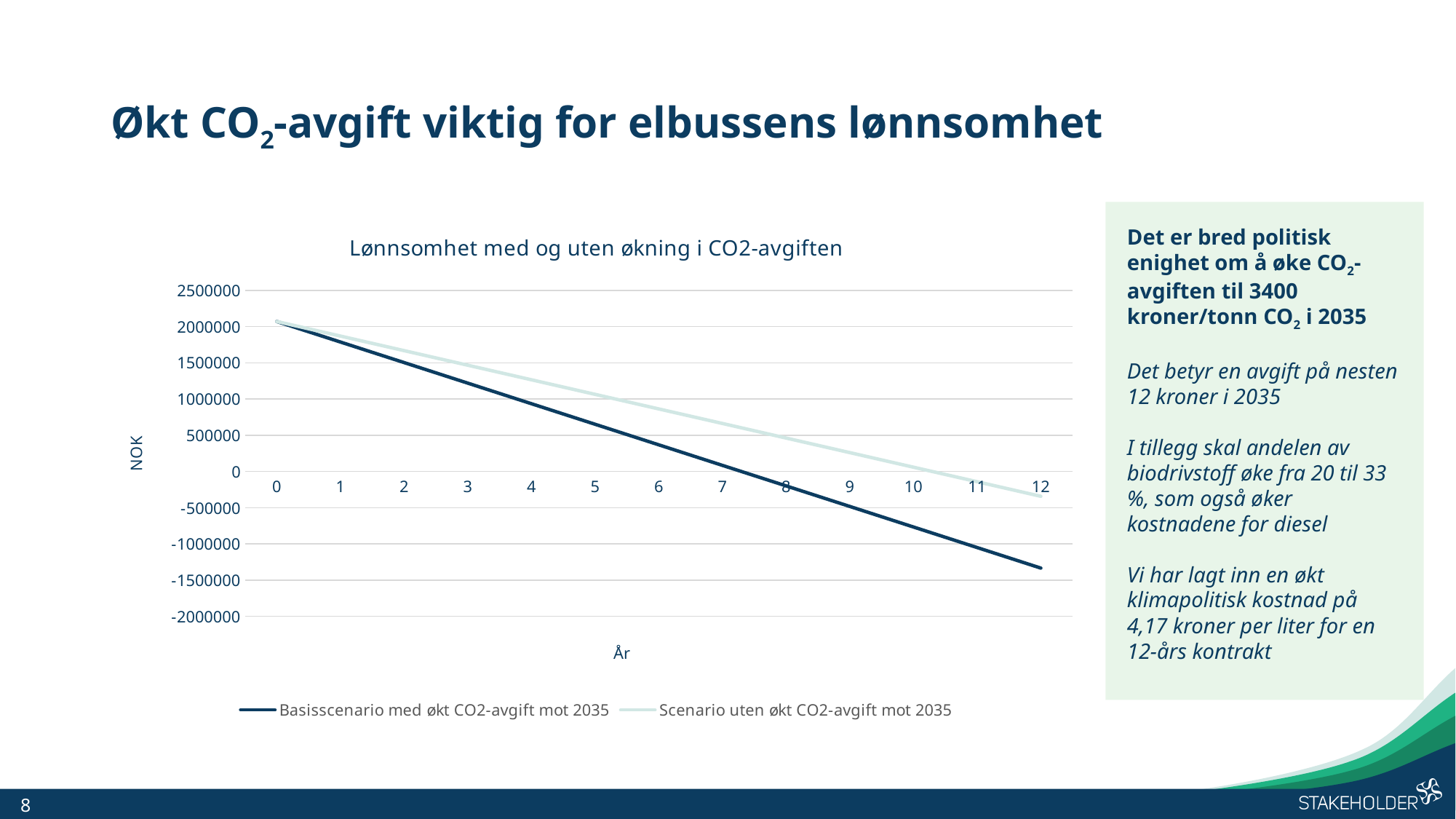
Is the value for 'Basisscenario med økt CO2-avgift mot 2035' at year 12 greater or less than -1000000? less What kind of chart is shown on the slide? line chart At year 12, which series has the higher value? Scenario uten økt CO2-avgift mot 2035 Is the value for 'Scenario uten økt CO2-avgift mot 2035' at year 12 greater or less than 0? less Do the values for 'Basisscenario med økt CO2-avgift mot 2035' rise or fall as the years increase? fall How many year points are shown along the x axis? 13 Is the value for 'Basisscenario med økt CO2-avgift mot 2035' at year 6 greater or less than 0? greater What is the label of the y axis? NOK How many series does the legend list? 2 Do the values for 'Scenario uten økt CO2-avgift mot 2035' rise or fall as the years increase? fall What is the title of the chart? Lønnsomhet med og uten økning i CO2-avgiften